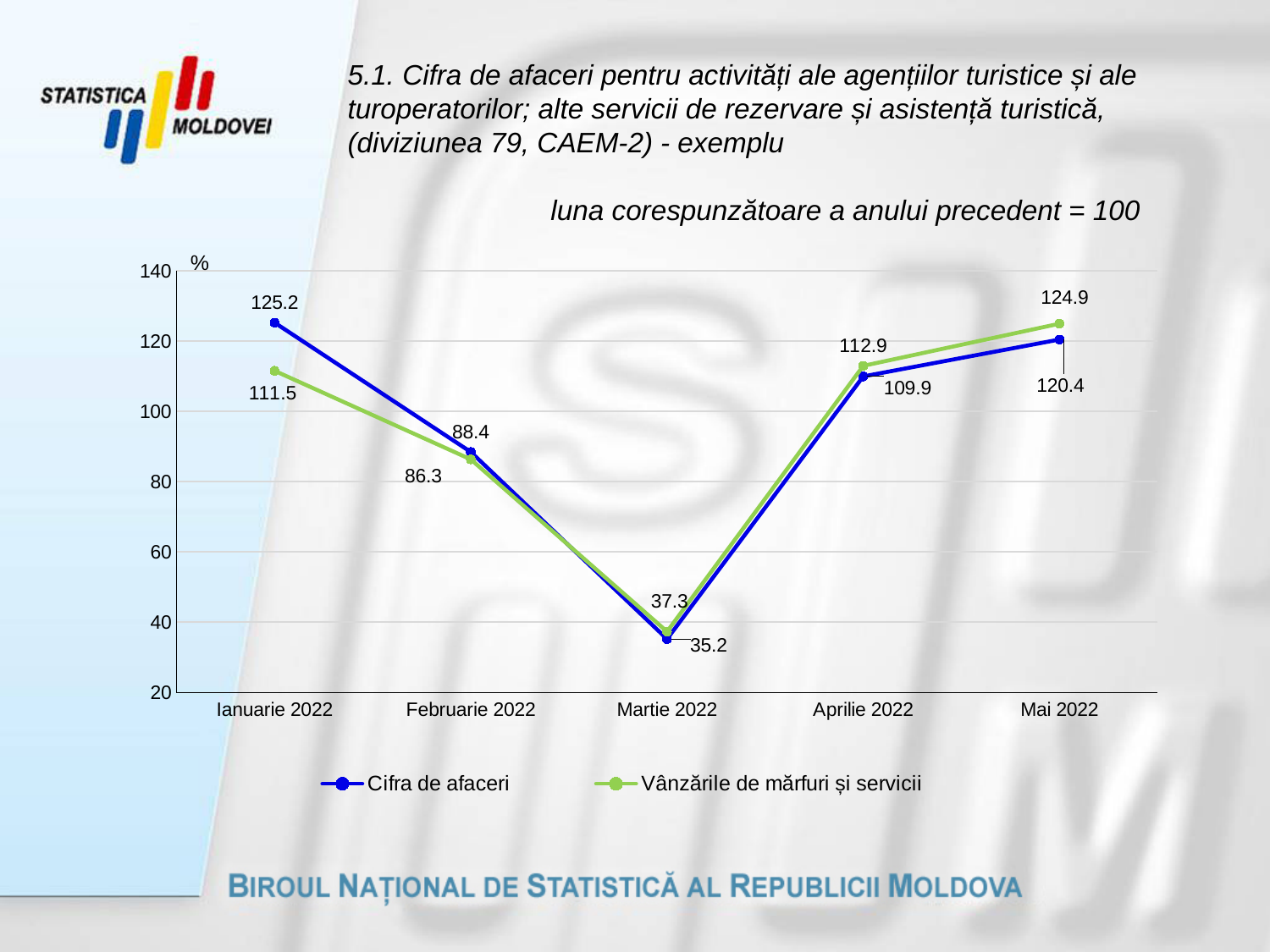
How many series does the legend list? 2 What unit is shown on the vertical axis? % In which month is Vânzările de mărfuri și servicii highest? Mai 2022 How many months are plotted on the x axis? 5 Which series has the larger value in Aprilie 2022? Vânzările de mărfuri și servicii What is the value of Cifra de afaceri for Ianuarie 2022? 125.2 In which month is Cifra de afaceri lowest? Martie 2022 Is the value of Cifra de afaceri for Martie 2022 greater or less than 40? less What is the value of Cifra de afaceri for Martie 2022? 35.2 What is the value of Vânzările de mărfuri și servicii for Mai 2022? 124.9 What type of chart is shown on the slide? line chart What is the difference between Cifra de afaceri and Vânzările de mărfuri și servicii in Ianuarie 2022? 13.7